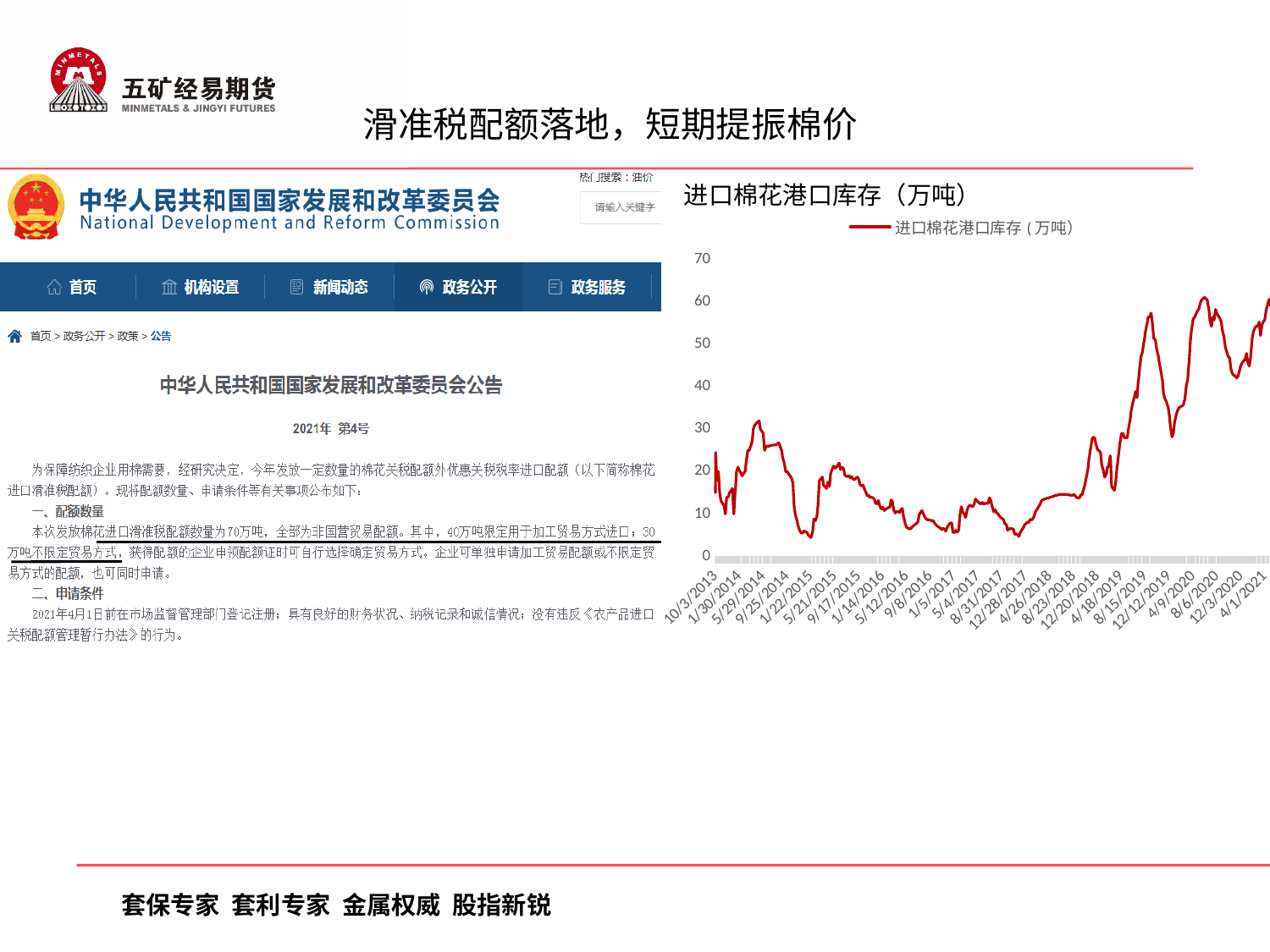
What is the title of the chart on the slide? 进口棉花港口库存（万吨） How many series does the legend of the chart list? 1 What is the highest tick value shown on the y axis of the chart? 70 What kind of chart is shown on the right side of the slide? line chart Is the value for 进口棉花港口库存 at 4/1/2021 greater or less than 50? greater Is the value for 进口棉花港口库存 at 10/3/2013 greater or less than 10? greater What is the legend entry of the chart? 进口棉花港口库存 ( 万吨 ) Overall, does the 进口棉花港口库存 line rise or fall from the start of the x axis to the end? rise Is the value for 进口棉花港口库存 around 1/22/2015 greater or less than 10? less Which is larger, the value for 进口棉花港口库存 at 10/3/2013 or at 4/1/2021? 4/1/2021